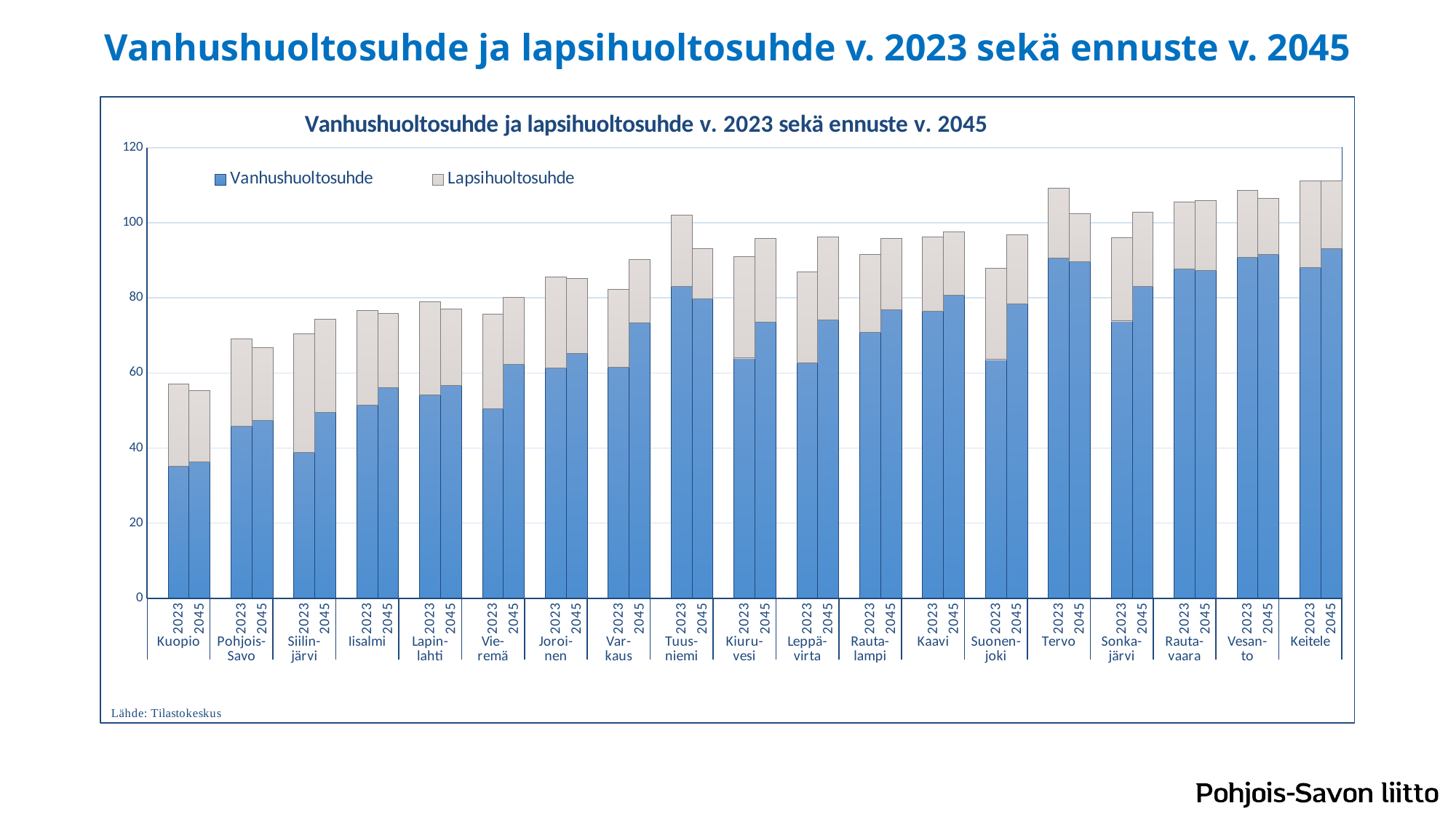
Is the total height of the stacked bar for Siilinjärvi in 2045 greater or less than 80? less Is the Vanhushuoltosuhde value for Kuopio in 2023 greater or less than 40? less Which series is drawn in blue? Vanhushuoltosuhde Which has the larger Vanhushuoltosuhde value in 2023, Kuopio or Keitele? Keitele Which municipality has the lowest stacked bars in the chart? Kuopio How many municipalities/regions are shown along the x axis? 19 For Suonenjoki, which year has the larger Vanhushuoltosuhde value, 2023 or 2045? 2045 What source is cited at the bottom of the chart? Tilastokeskus Is the total height of the stacked bar for Tervo in 2023 greater or less than 100? greater How many series does the legend list? 2 What kind of chart is shown on the slide? Stacked bar chart